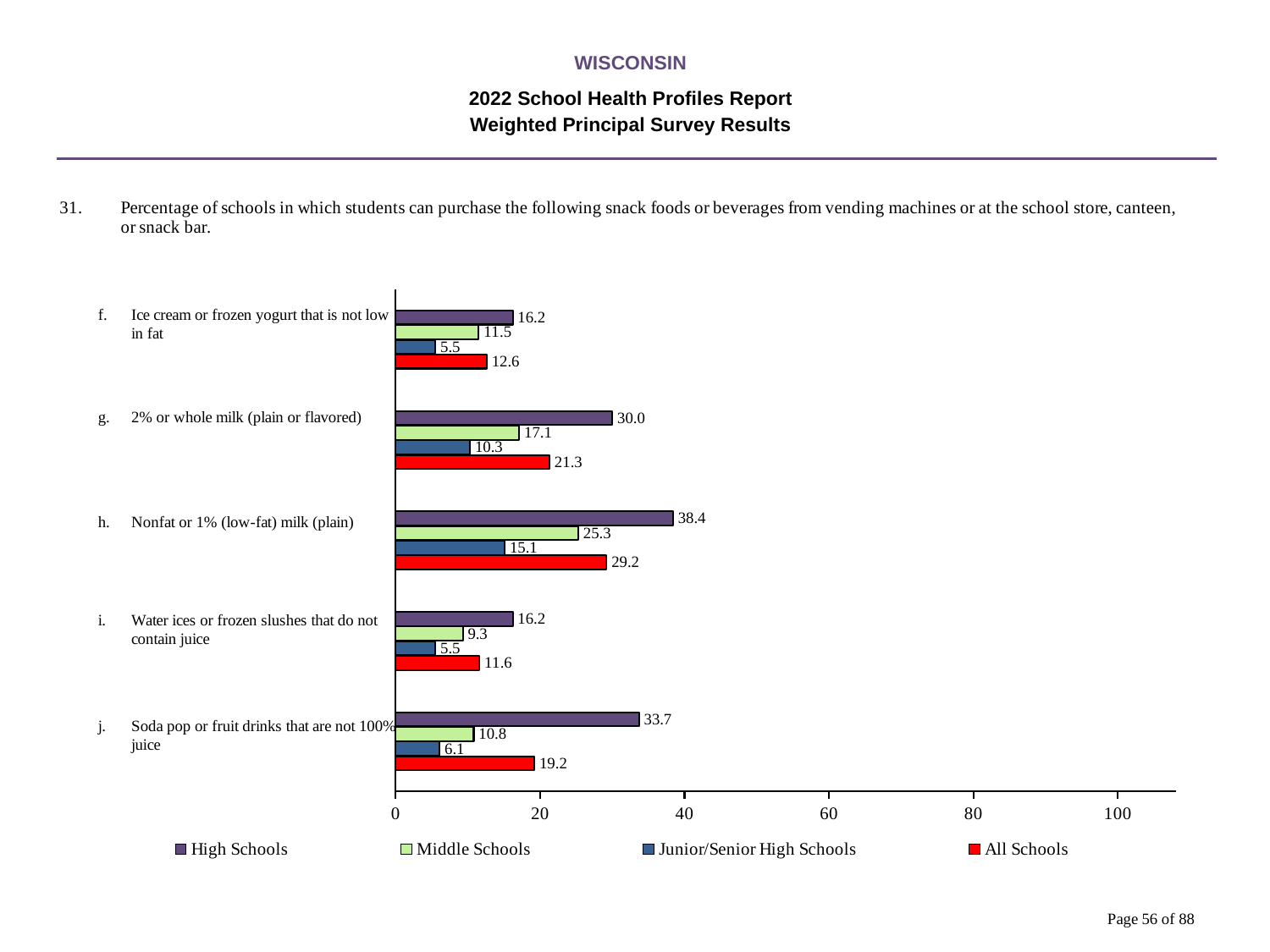
What is the value for All Schools for '2% or whole milk (plain or flavored)'? 21.3 Which category has the lowest value for All Schools? Water ices or frozen slushes that do not contain juice Which is larger for 'Ice cream or frozen yogurt that is not low in fat': the Middle Schools value or the All Schools value? All Schools What is the value for Middle Schools for 'Water ices or frozen slushes that do not contain juice'? 9.3 Which category has the highest value for High Schools? Nonfat or 1% (low-fat) milk (plain) What is the value for High Schools for 'Nonfat or 1% (low-fat) milk (plain)'? 38.4 How many snack food or beverage categories are shown in the chart? 5 Is the High Schools value for '2% or whole milk (plain or flavored)' greater or less than 20? greater How many series does the legend list? 4 What kind of chart is shown on the slide? Bar chart What is the difference between the High Schools and Middle Schools values for 'Soda pop or fruit drinks that are not 100% juice'? 22.9 What is the value for Junior/Senior High Schools for 'Soda pop or fruit drinks that are not 100% juice'? 6.1